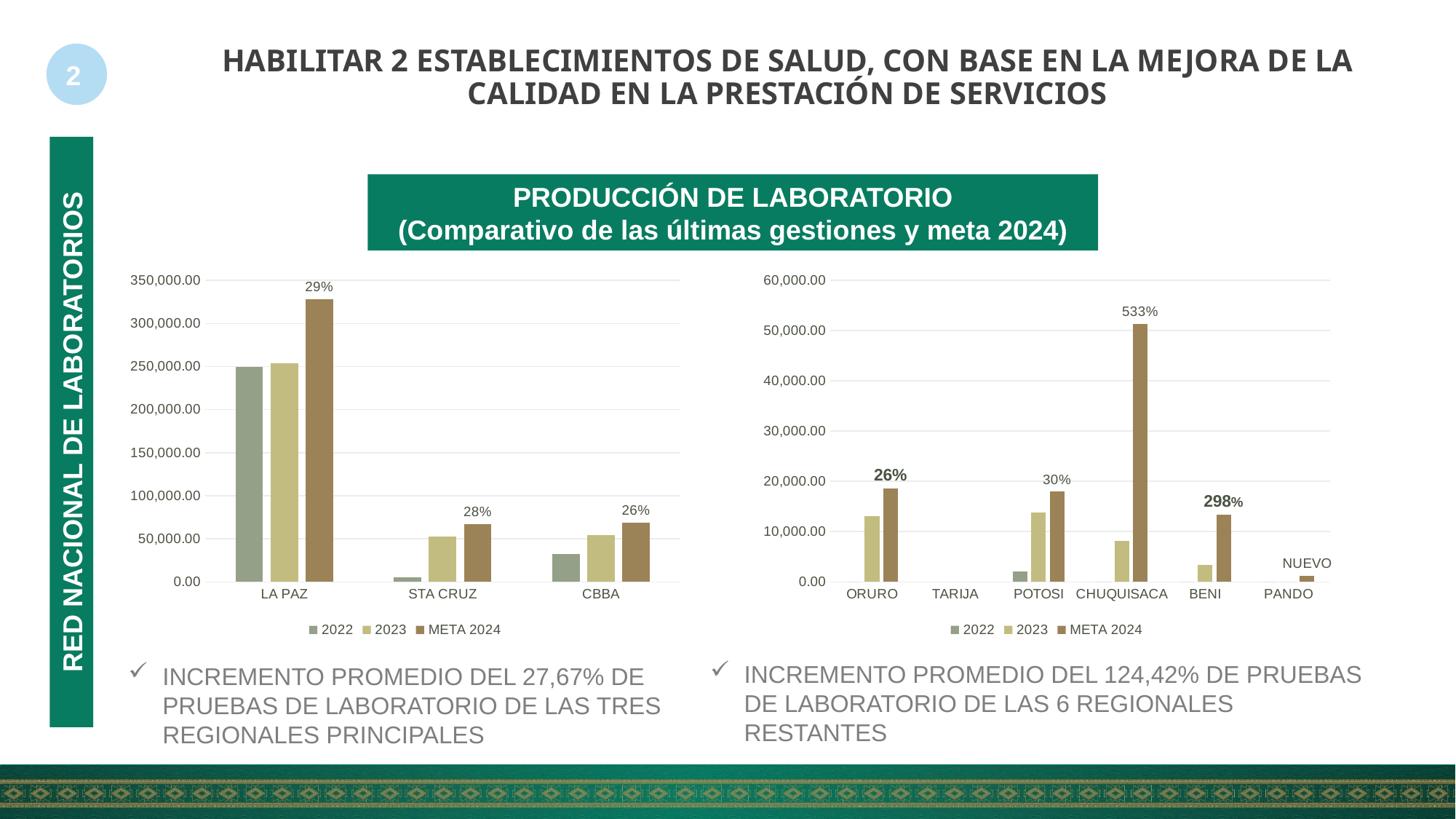
In the right chart, is the META 2024 value for ORURO greater or less than 20,000.00? less In the left chart, which category has the highest META 2024 bar? LA PAZ In the right chart, which category has the highest META 2024 bar? CHUQUISACA In the right chart, what percentage label is printed above the META 2024 bar for CHUQUISACA? 533% In the left chart, which is larger for STA CRUZ: the 2022 bar or the 2023 bar? 2023 In the left chart, is the META 2024 value for LA PAZ greater or less than 300,000.00? greater In the left chart, what percentage label is printed above the META 2024 bar for LA PAZ? 29% In the left chart, how many series does the legend list? 3 In the left chart, how many categories are shown on the x axis? 3 What kind of chart is the right chart? bar chart In the right chart, how many categories are shown on the x axis? 6 In the right chart, what label is printed above the PANDO bar? NUEVO